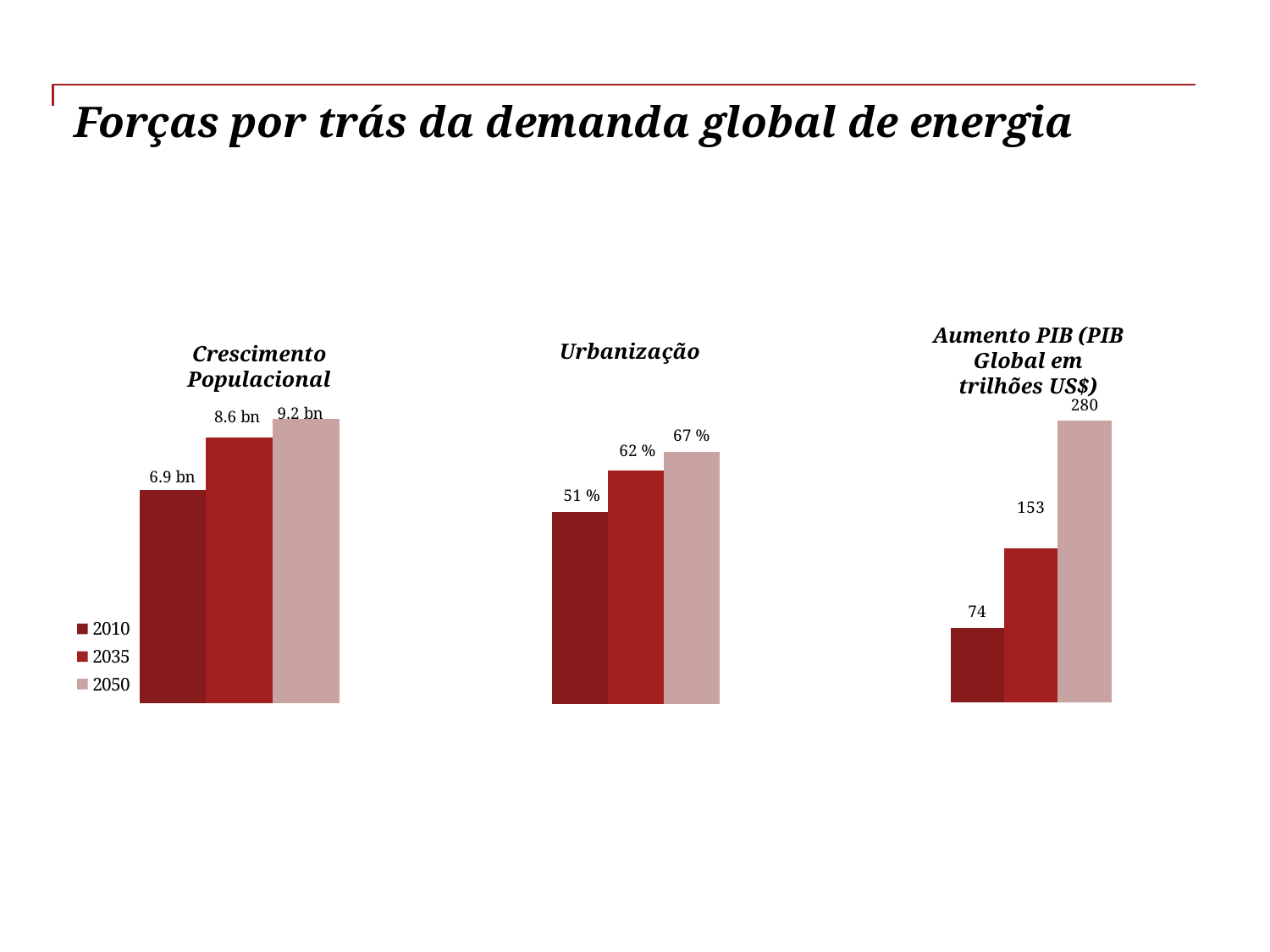
In the 'Aumento PIB' chart, what is the value for 2050? 280 In the 'Aumento PIB' chart, which year has the highest value? 2050 In the 'Urbanização' chart, what is the value for 2035? 62 % In the 'Aumento PIB' chart, what is the value for 2010? 74 In the 'Crescimento Populacional' chart, what is the value for 2050? 9.2 bn In the 'Crescimento Populacional' chart, what is the value for 2010? 6.9 bn In the 'Aumento PIB' chart, what is the difference between the values for 2050 and 2010? 206 In the 'Urbanização' chart, what is the difference between the values for 2050 and 2010? 16 % In the 'Urbanização' chart, which year has the lowest value? 2010 What kind of chart is the 'Urbanização' chart? Bar chart How many series does the legend on the slide list? 3 In the 'Crescimento Populacional' chart, which is larger, the value for 2035 or the value for 2010? 2035